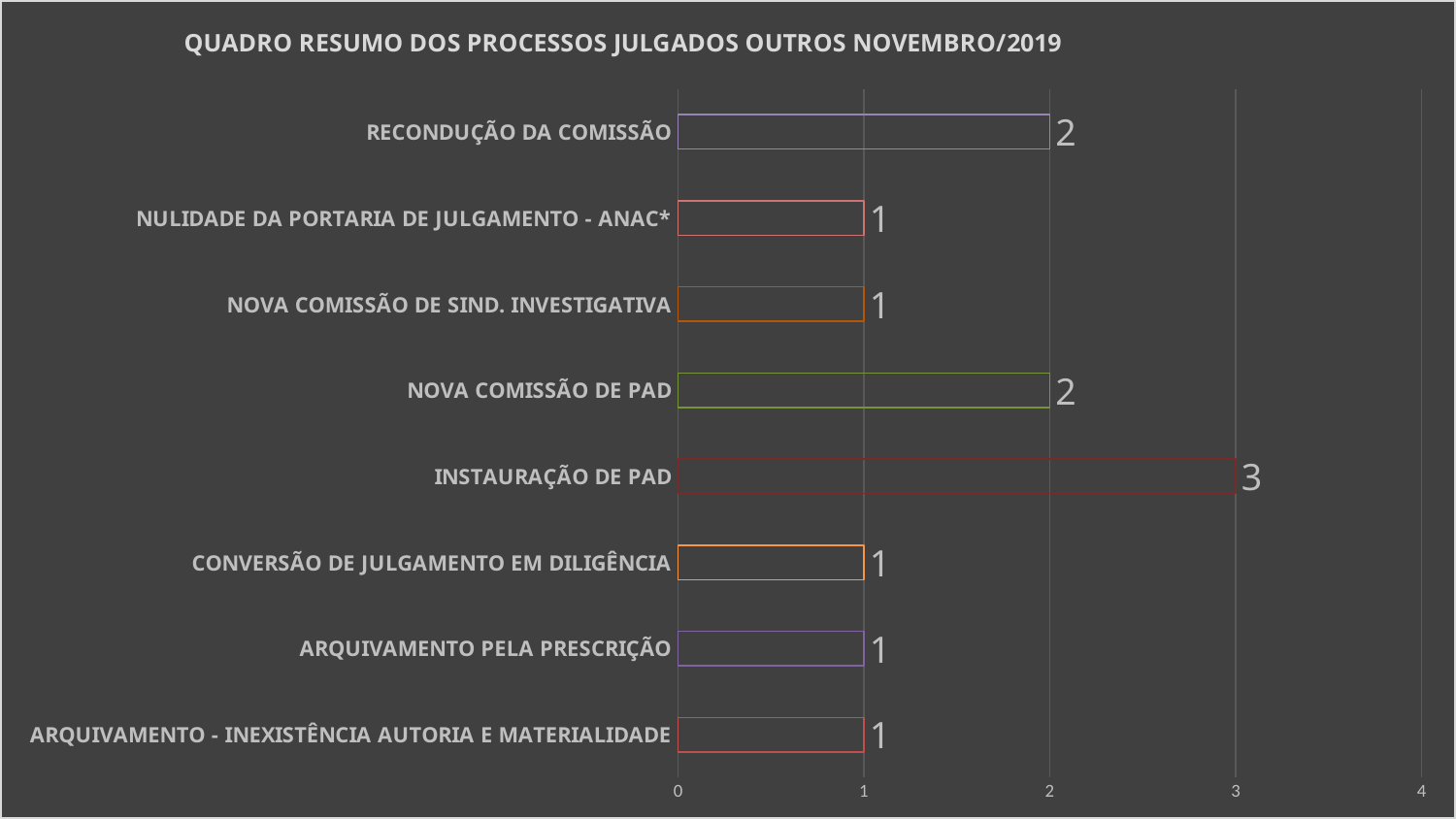
Which is larger, the value for RECONDUÇÃO DA COMISSÃO or the value for CONVERSÃO DE JULGAMENTO EM DILIGÊNCIA? RECONDUÇÃO DA COMISSÃO What is the title of the chart? QUADRO RESUMO DOS PROCESSOS JULGADOS OUTROS NOVEMBRO/2019 Which category has the highest value? INSTAURAÇÃO DE PAD What is the value for INSTAURAÇÃO DE PAD? 3 How many categories have a value of 1? 5 What is the value for NOVA COMISSÃO DE PAD? 2 What is the value for ARQUIVAMENTO PELA PRESCRIÇÃO? 1 What kind of chart is shown on the slide? Bar chart What is the value for RECONDUÇÃO DA COMISSÃO? 2 What is the difference between the values for INSTAURAÇÃO DE PAD and NOVA COMISSÃO DE PAD? 1 What is the highest value shown on the x axis? 4 How many categories are shown in the chart? 8